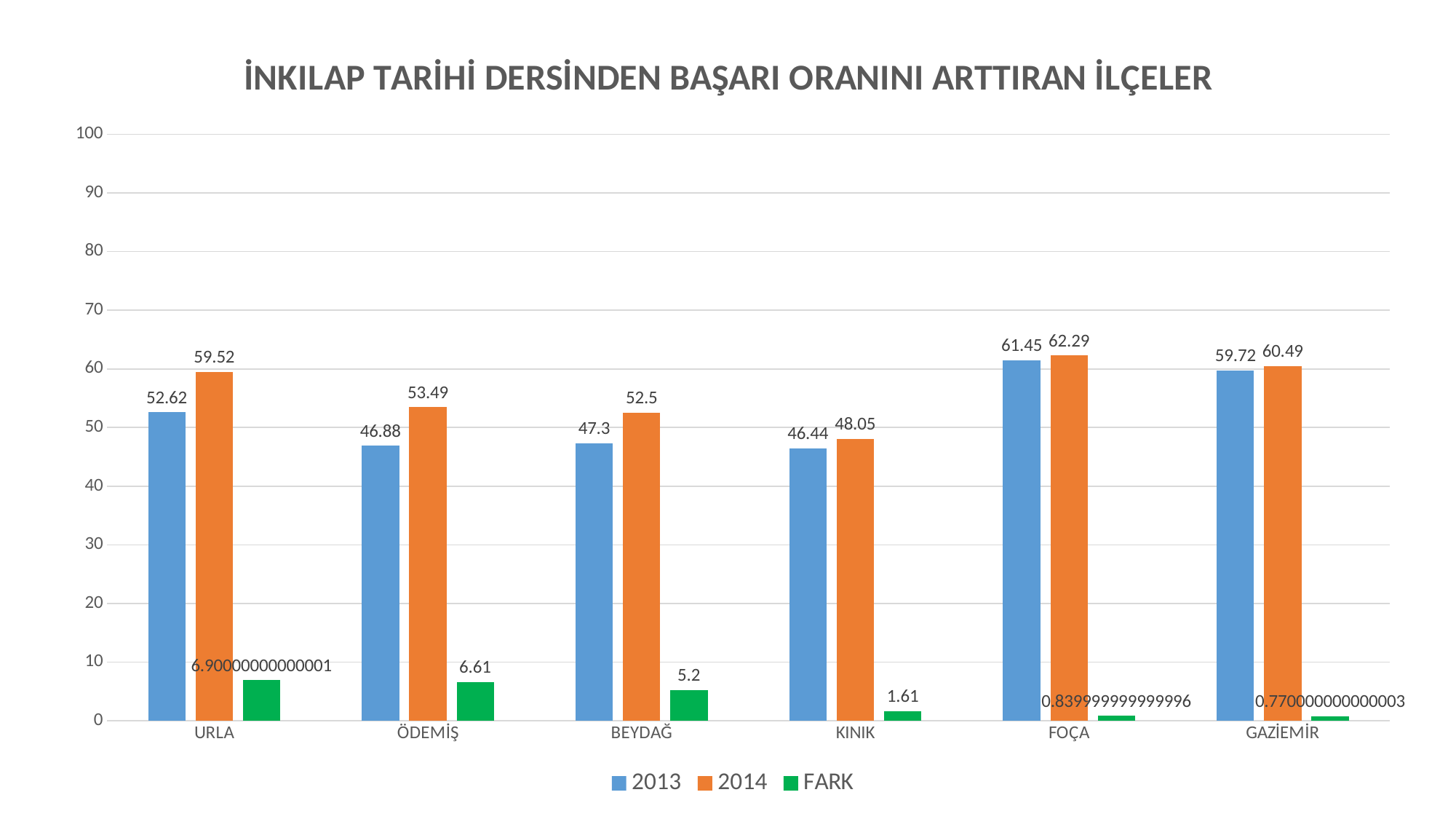
What type of chart is shown on the slide? Bar chart How many series does the legend list? 3 Which is larger, the 2013 value for GAZİEMİR or the 2013 value for URLA? GAZİEMİR What is the 2014 value for KINIK? 48.05 What is the difference between the 2014 and 2013 values for BEYDAĞ? 5.2 How many categories are shown on the x axis? 6 What is the FARK value for ÖDEMİŞ? 6.61 What is the 2013 value for URLA? 52.62 What is the 2014 value for FOÇA? 62.29 Which category has the highest 2014 value? FOÇA Which category has the highest FARK value? URLA Which category has the lowest 2013 value? KINIK